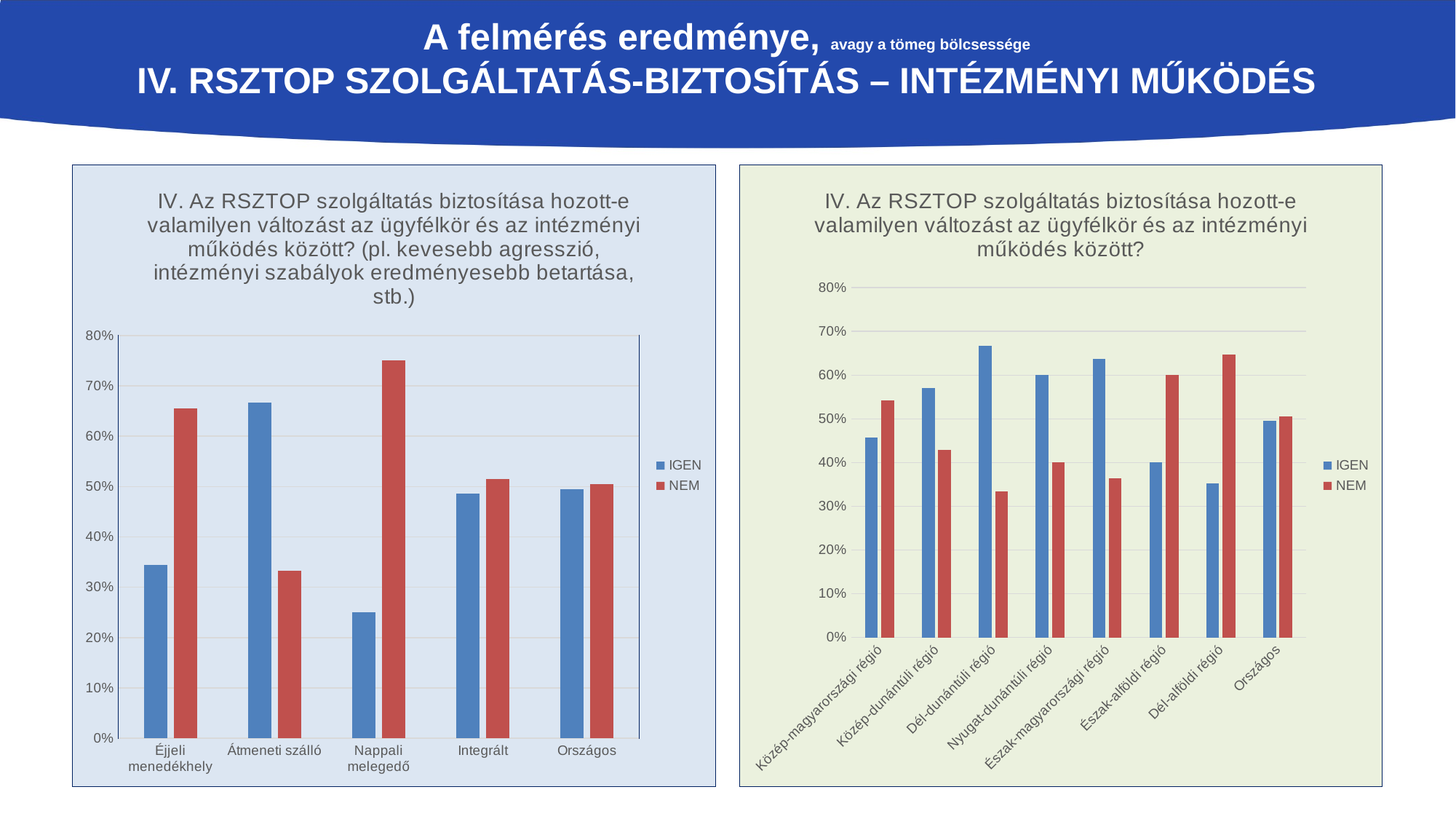
In the left chart, which category has the lowest IGEN value? Nappali melegedő In the left chart, is the NEM value for Nappali melegedő greater or less than 70%? greater In the left chart, is the IGEN value for Éjjeli menedékhely greater or less than 40%? less In the right chart, which category has the lowest NEM value? Dél-dunántúli régió In the left chart, which category has the highest NEM value? Nappali melegedő In the left chart, how many series does the legend list? 2 In the left chart, what kind of chart is shown? bar chart In the left chart, which category has the highest IGEN value? Átmeneti szálló In the right chart, for Közép-magyarországi régió, which is larger, IGEN or NEM? NEM In the right chart, how many categories are shown on the x axis? 8 In the right chart, which category has the highest IGEN value? Dél-dunántúli régió In the left chart, how many categories are shown on the x axis? 5